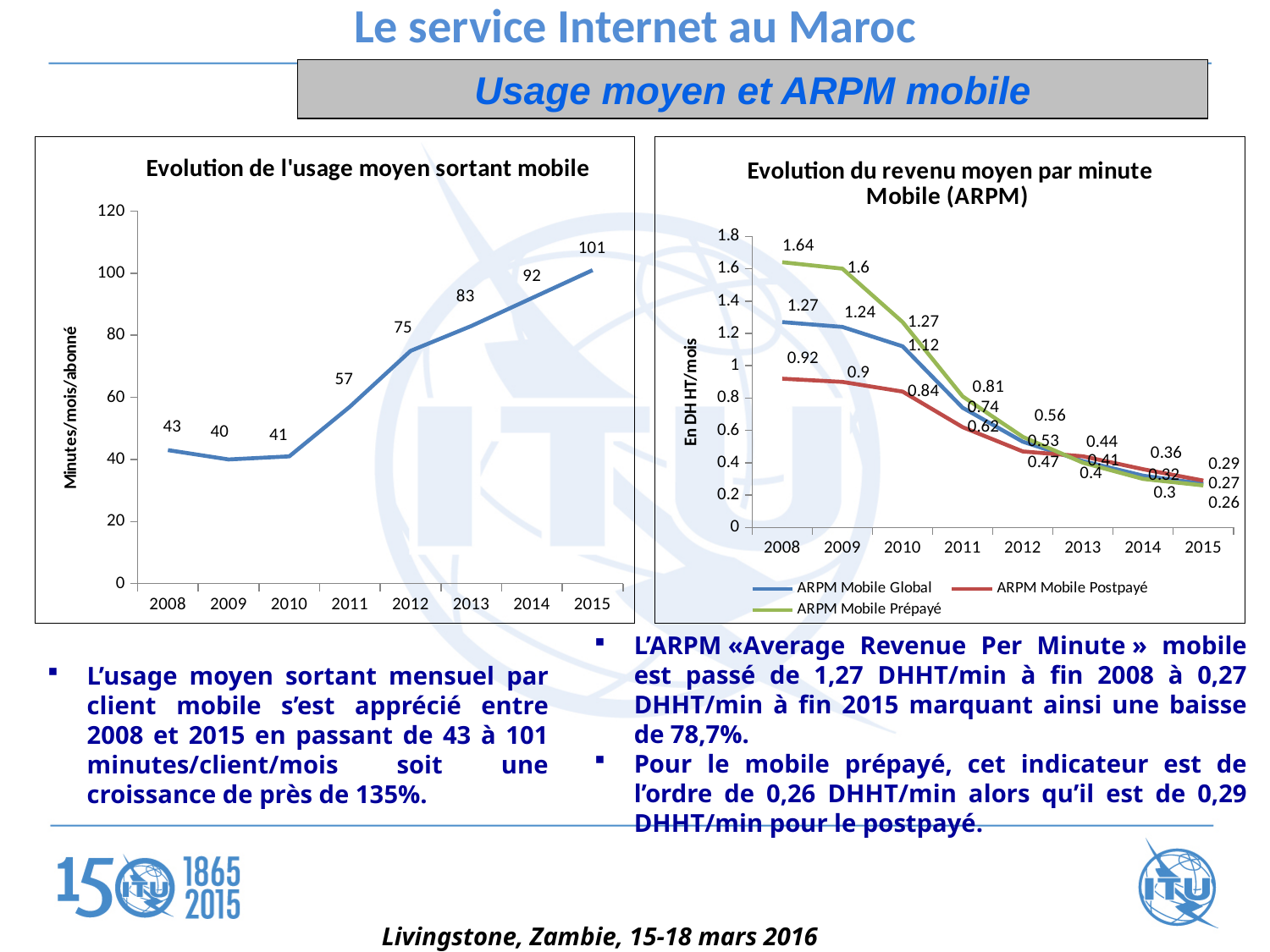
In the chart 'Evolution du revenu moyen par minute Mobile (ARPM)', what is the value of ARPM Mobile Global in 2008? 1.27 In the chart 'Evolution de l'usage moyen sortant mobile', what is the value for 2008? 43 In the chart 'Evolution de l'usage moyen sortant mobile', what is the value for 2015? 101 In the chart 'Evolution de l'usage moyen sortant mobile', how many years are plotted on the x axis? 8 What kind of chart is 'Evolution du revenu moyen par minute Mobile (ARPM)'? line chart In the chart 'Evolution de l'usage moyen sortant mobile', which year has the lowest value? 2009 In the chart 'Evolution du revenu moyen par minute Mobile (ARPM)', how many series does the legend list? 3 In the chart 'Evolution de l'usage moyen sortant mobile', which year has the highest value? 2015 In the chart 'Evolution du revenu moyen par minute Mobile (ARPM)', which series has the higher value in 2008, ARPM Mobile Postpayé or ARPM Mobile Prépayé? ARPM Mobile Prépayé In the chart 'Evolution du revenu moyen par minute Mobile (ARPM)', what is the value of ARPM Mobile Prépayé in 2008? 1.64 In the chart 'Evolution de l'usage moyen sortant mobile', do the values generally rise or fall from 2010 to 2015? rise In the chart 'Evolution de l'usage moyen sortant mobile', what is the difference between the 2012 value and the 2011 value? 18